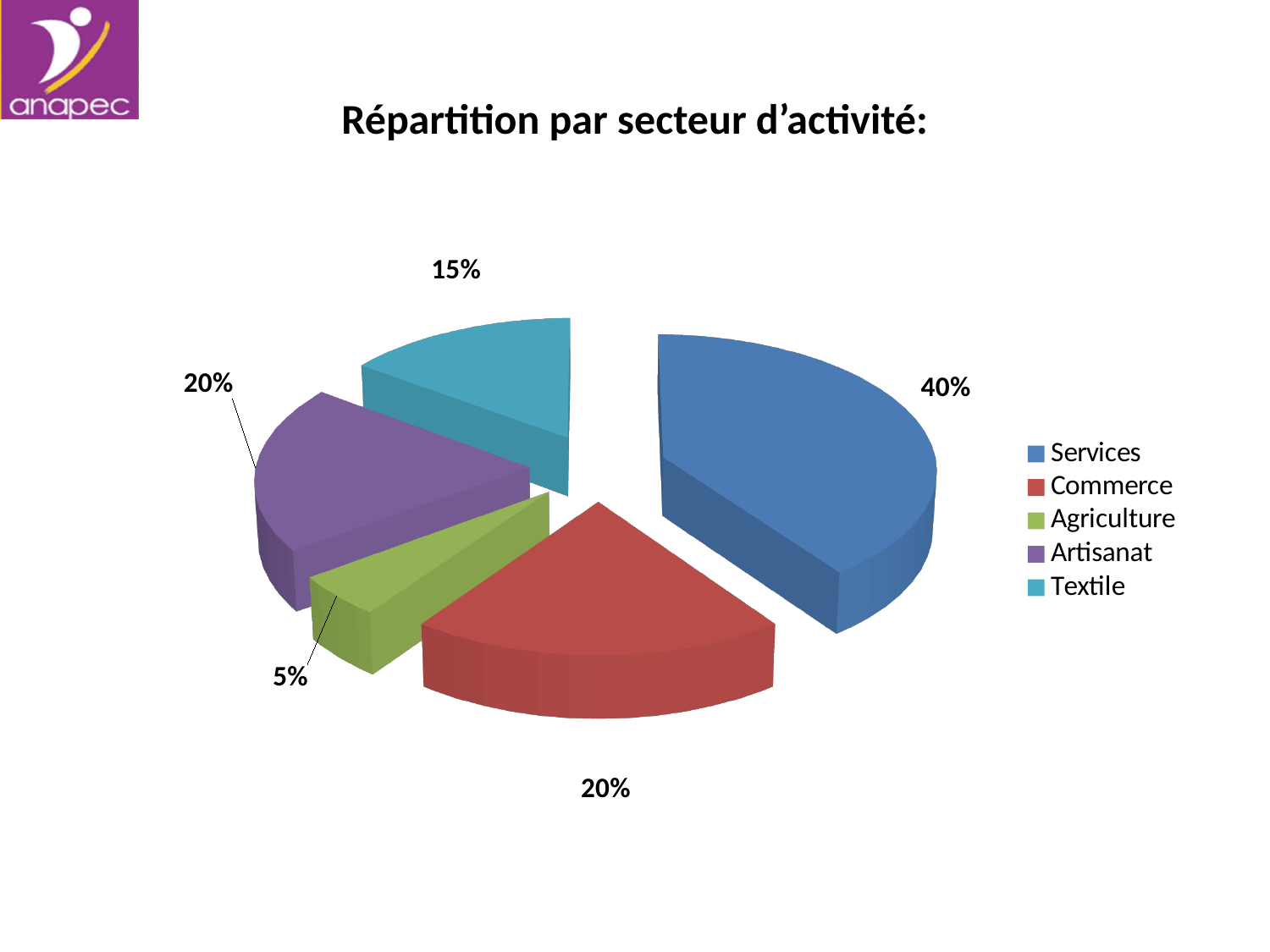
What share of the pie does Textile have? 15% Which sector has the smallest share of the pie? Agriculture What share of the pie does Services have? 40% Which sector has the largest share of the pie? Services Which is larger, the share for Textile or the share for Agriculture? Textile What kind of chart is shown on the slide? pie chart What is the title of the chart? Répartition par secteur d'activité: How many sectors are shown in the pie chart? 5 What share of the pie does Agriculture have? 5% What share of the pie does Artisanat have? 20% What share of the pie does Commerce have? 20% What is the difference in percentage points between Services and Textile? 25